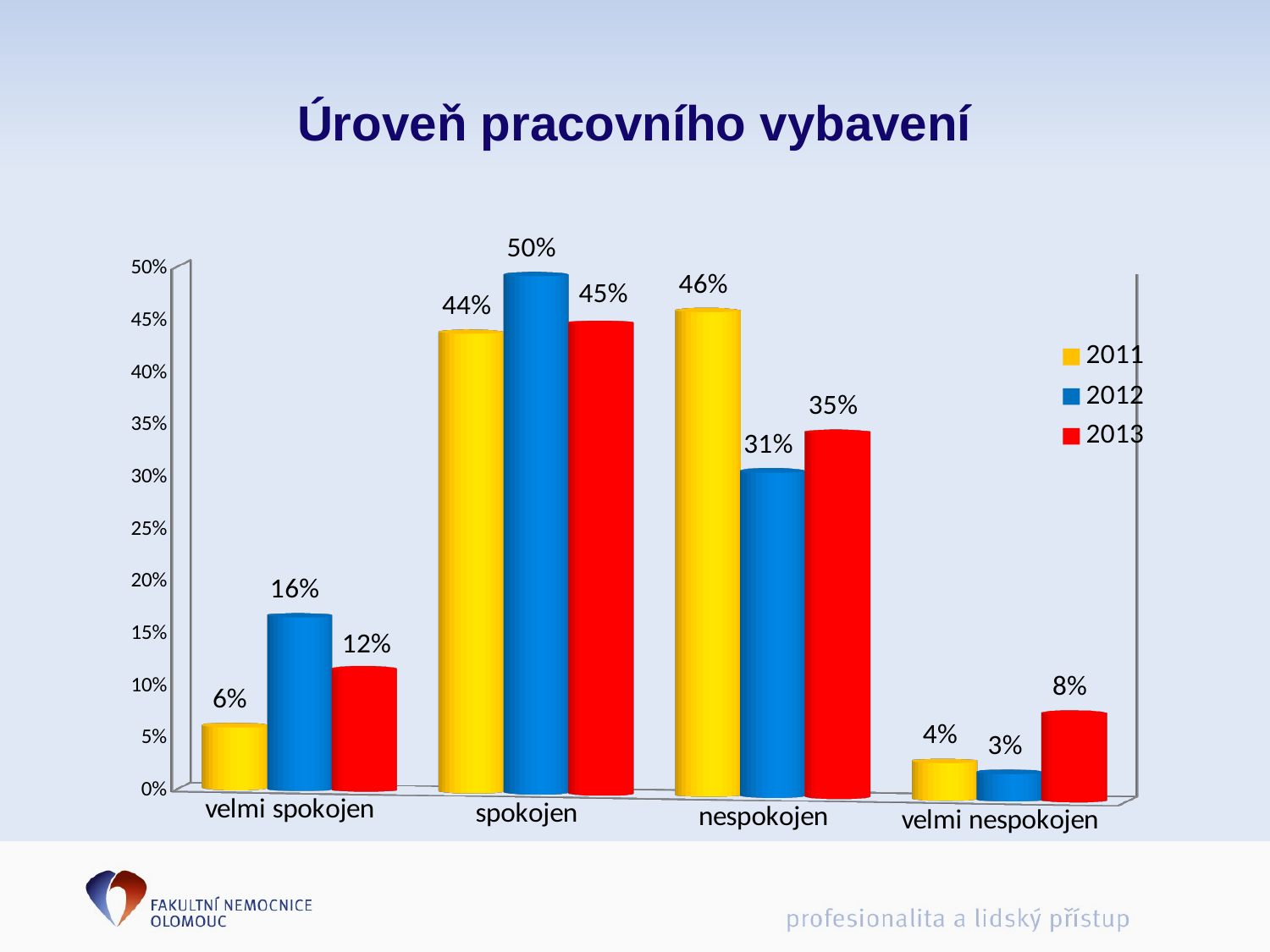
Which category has the highest value for the 2013 series? spokojen How many categories are shown on the x axis? 4 What is the difference between the 2011 and 2012 values in the 'nespokojen' category? 15% What is the value for 2012 in the 'spokojen' category? 50% How many series does the legend list? 3 What is the value for 2011 in the 'nespokojen' category? 46% What is the value for 2013 in the 'velmi nespokojen' category? 8% What is the title of the slide? Úroveň pracovního vybavení Which is larger in the 'velmi spokojen' category: the 2012 value or the 2013 value? 2012 Which category has the lowest value for the 2012 series? velmi nespokojen What is the value for 2011 in the 'velmi spokojen' category? 6% What kind of chart is shown on the slide? bar chart